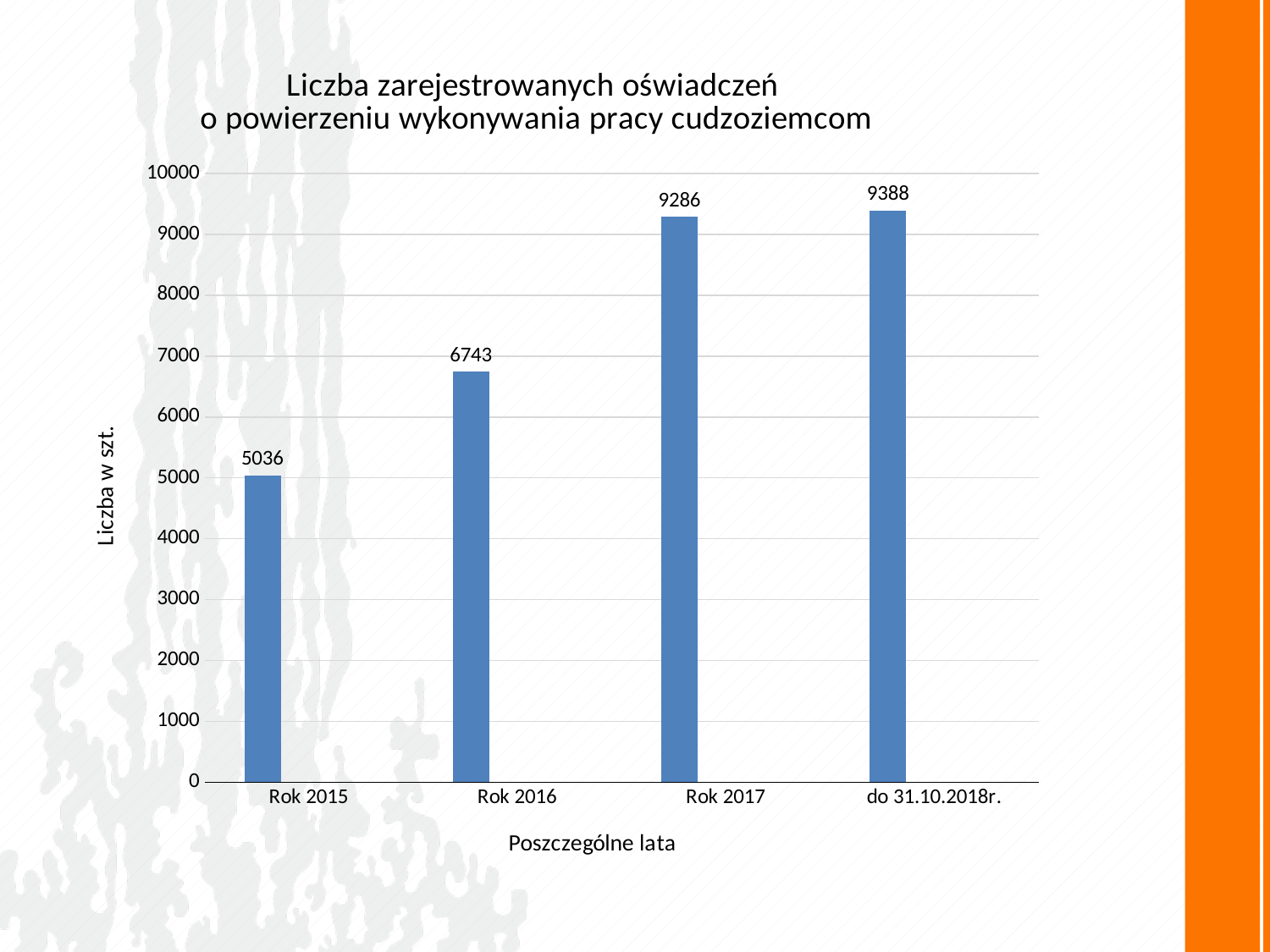
What is the value for Rok 2017? 9286 Which is larger, the value for Rok 2016 or the value for Rok 2017? Rok 2017 What kind of chart is this? bar chart Which category has the lowest value? Rok 2015 What is the difference between the values for do 31.10.2018r. and Rok 2017? 102 What is the value for Rok 2016? 6743 What is the value for Rok 2015? 5036 Do the values rise or fall from Rok 2015 to do 31.10.2018r.? rise Which category has the highest value? do 31.10.2018r. What is the difference between the values for Rok 2016 and Rok 2015? 1707 What is the value for do 31.10.2018r.? 9388 How many categories are shown on the x axis? 4